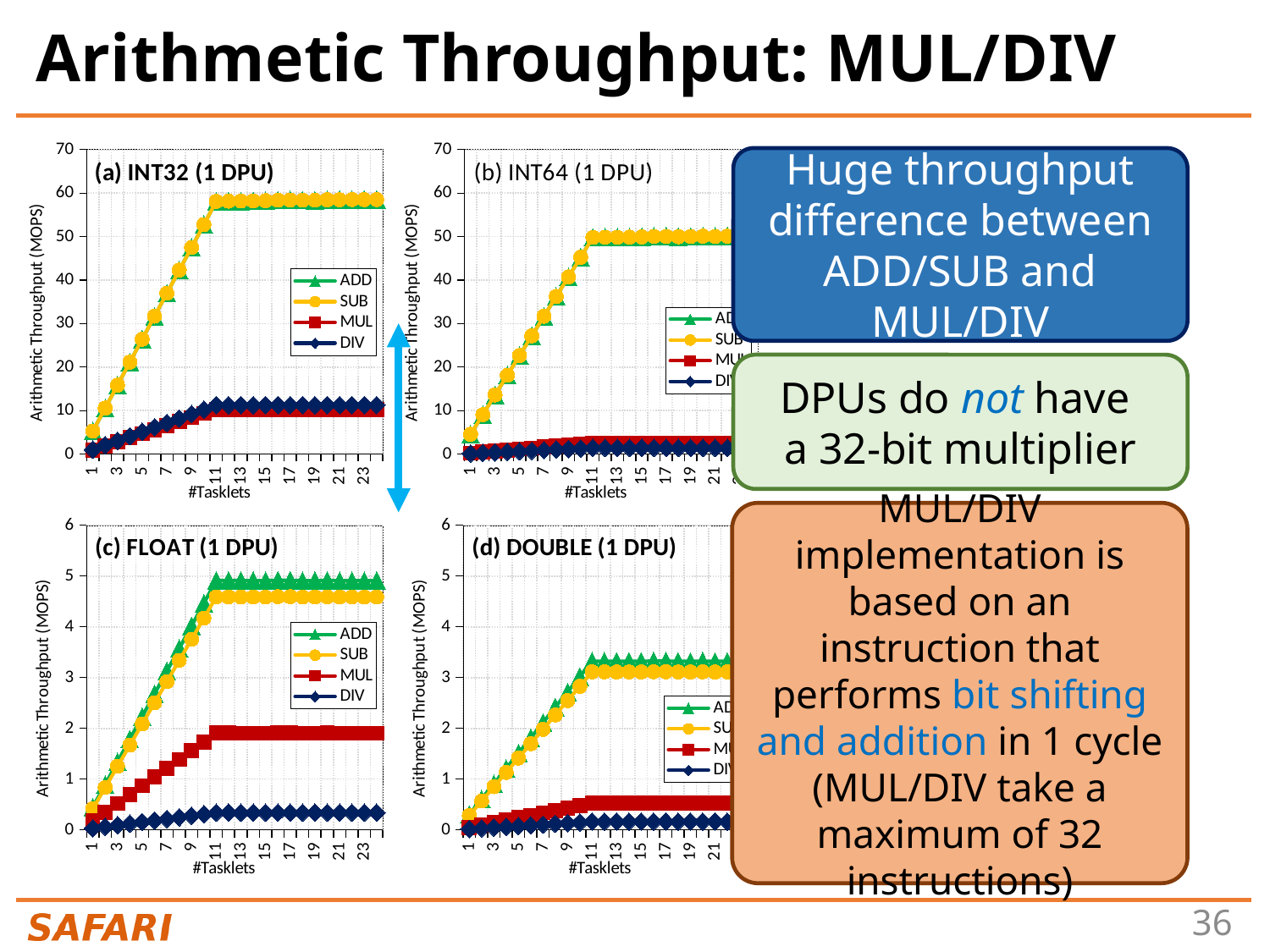
In chart (b) INT64 (1 DPU), is the SUB throughput at 21 tasklets greater or less than 40? greater In chart (c) FLOAT (1 DPU), is the ADD throughput at 23 tasklets greater or less than 4? greater In chart (a) INT32 (1 DPU), is the ADD throughput at 23 tasklets greater or less than 50? greater How many series does the legend of chart (a) INT32 (1 DPU) list? 4 What kind of chart is chart (a) INT32 (1 DPU)? line chart In chart (a) INT32 (1 DPU), which is larger at 23 tasklets, ADD or MUL? ADD In chart (c) FLOAT (1 DPU), which series has the lowest throughput at 23 tasklets? DIV In chart (a) INT32 (1 DPU), does the ADD throughput rise or fall as #Tasklets increases from 1 to 11? rise What is the y-axis label of chart (c) FLOAT (1 DPU)? Arithmetic Throughput (MOPS)